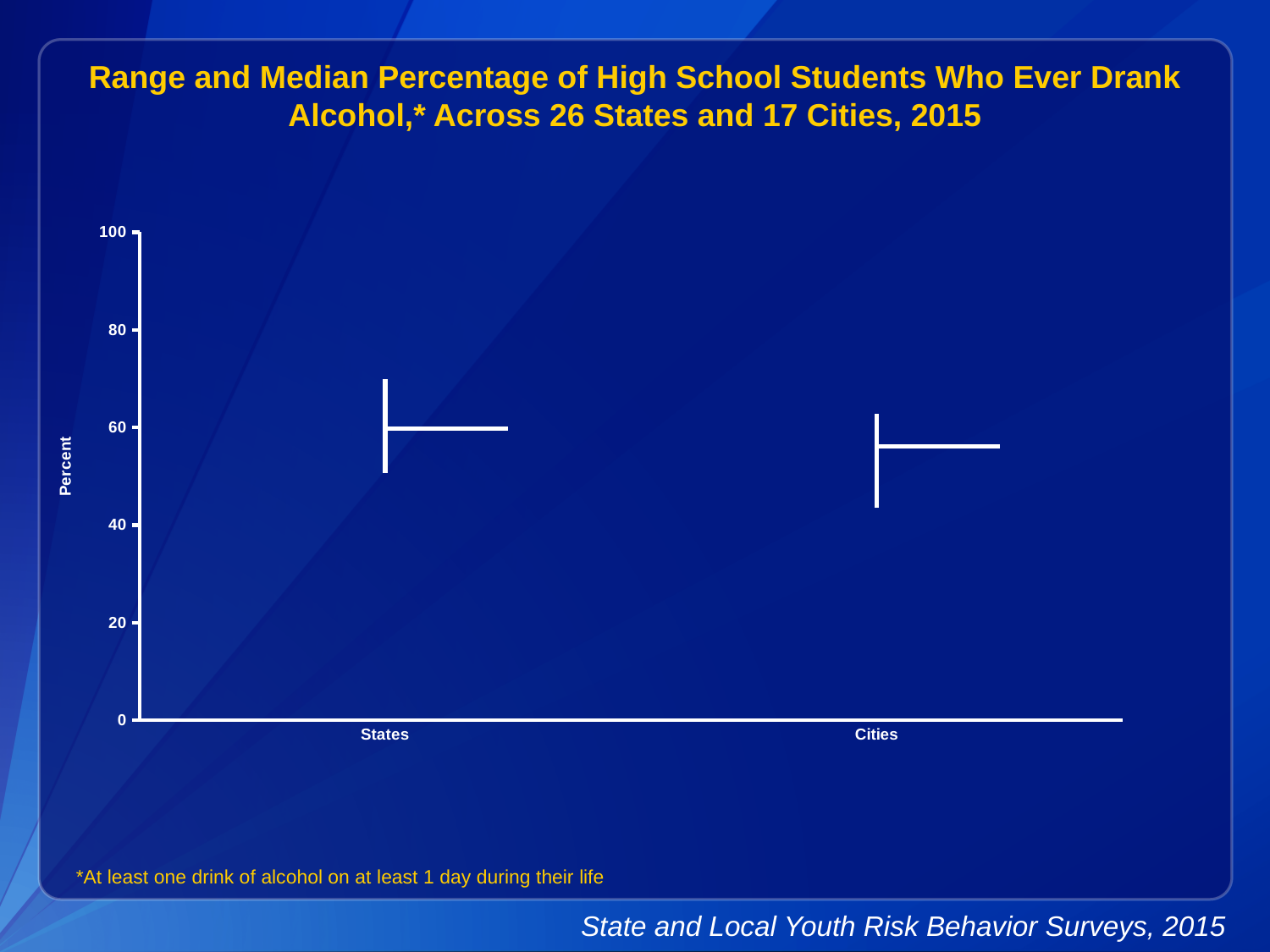
Is the bottom of the range for States greater or less than 40? greater Is the bottom of the range for Cities greater or less than 60? less Which category has the higher median value, States or Cities? States What is the highest value shown on the y axis of the chart? 100 Is the median value for Cities greater or less than 40? greater What is the label on the y axis of the chart? Percent How many categories are shown on the x axis of the chart? 2 What are the two categories shown on the x axis? States and Cities